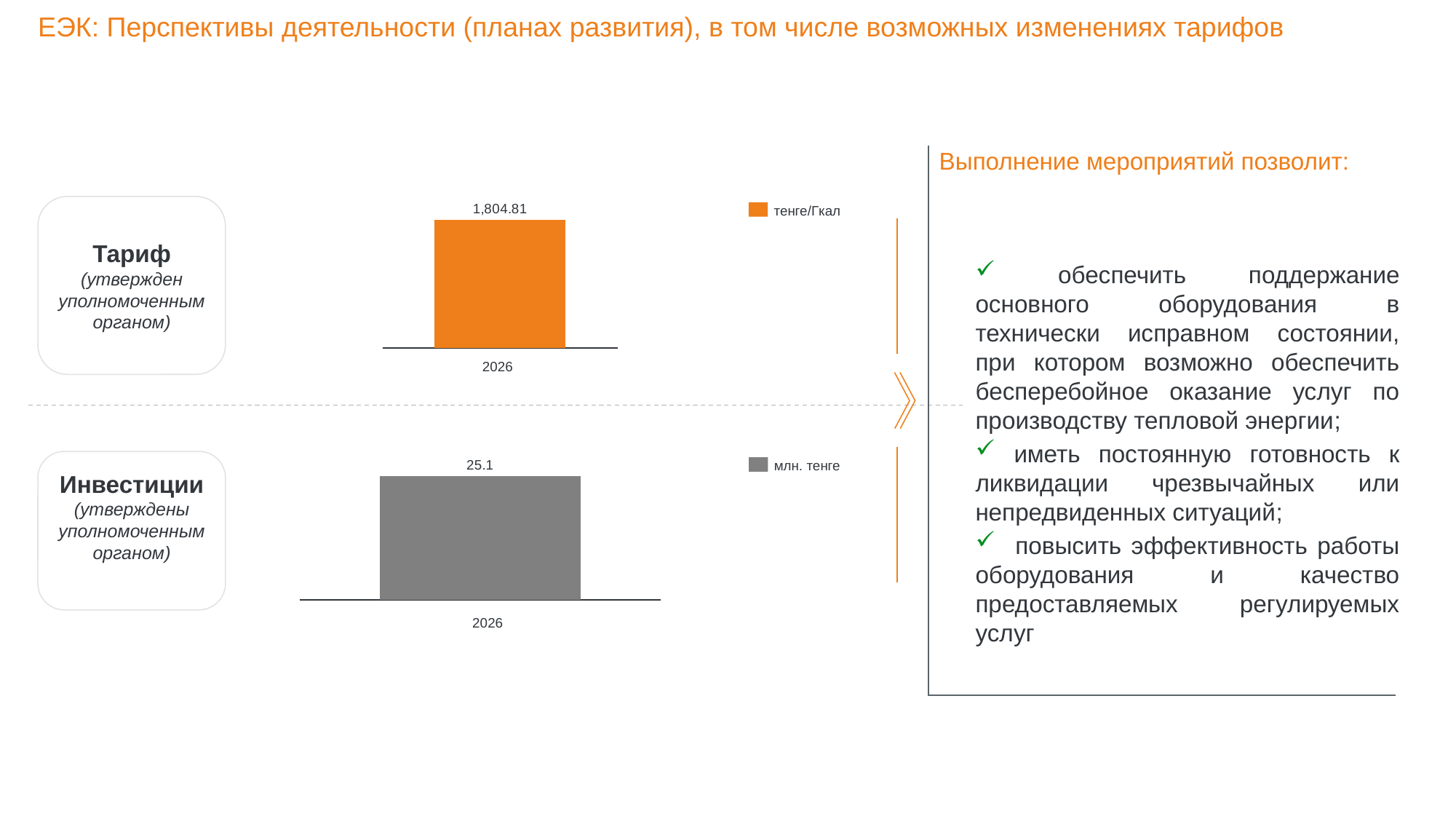
In the bottom chart (Инвестиции), how many series does the legend list? 1 In the bottom chart (Инвестиции), what colour is the bar? grey In the bottom chart (Инвестиции), what is the value shown for 2026? 25.1 What kind of chart is the top chart (Тариф)? bar chart In the bottom chart (Инвестиции), how many categories are shown on the x axis? 1 In the top chart (Тариф), what is the value shown for 2026? 1,804.81 In the top chart (Тариф), how many bars are plotted? 1 In the top chart (Тариф), which year is shown on the x axis? 2026 What kind of chart is the bottom chart (Инвестиции)? bar chart In the top chart (Тариф), how many series does the legend list? 1 In the top chart (Тариф), what is the legend entry? тенге/Гкал